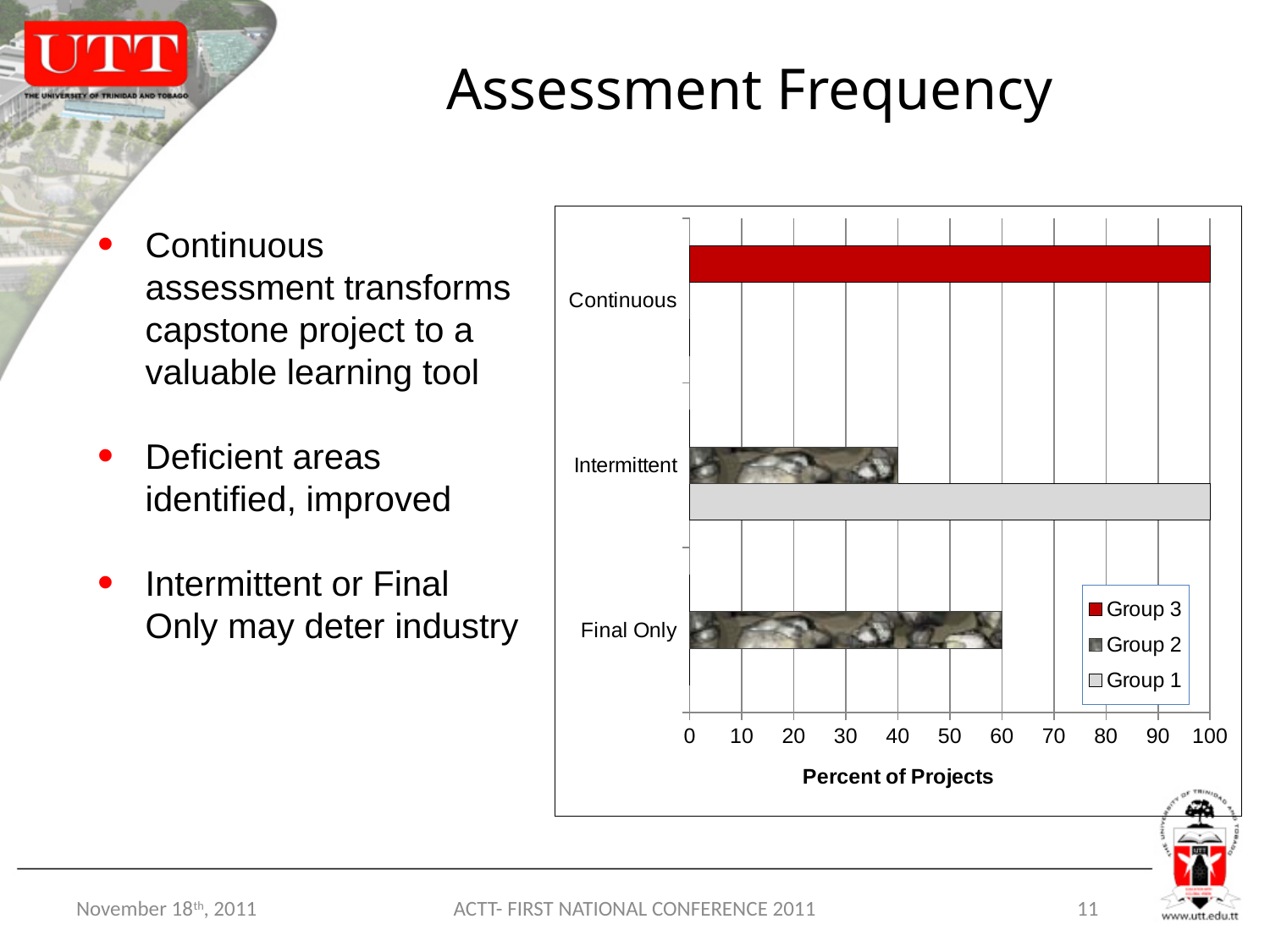
What is the x-axis title of the chart? Percent of Projects What is the Group 1 value for Intermittent? 100 What kind of chart is shown on the slide? bar chart Which category has the higher Group 2 value, Intermittent or Final Only? Final Only What is the Group 3 value for Continuous? 100 What is the Group 2 value for Intermittent? 40 Is the Group 2 value for Intermittent greater or less than 50? less How many series does the legend list? 3 What is the Group 2 value for Final Only? 60 What is the difference between the Group 2 values for Final Only and Intermittent? 20 How many categories are shown on the vertical axis of the chart? 3 Which legend entry is shown in red? Group 3